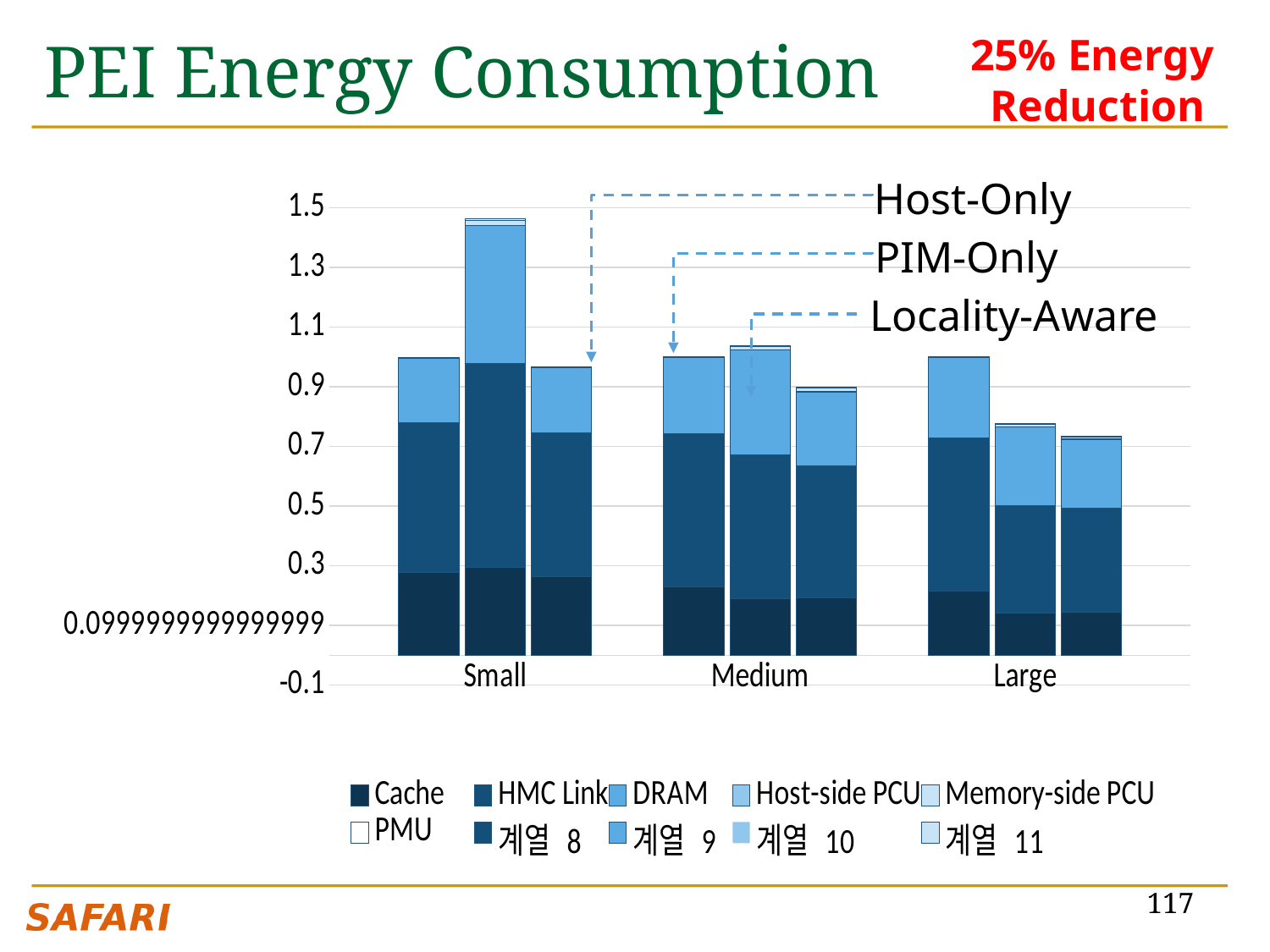
What kind of chart is shown on the slide? stacked bar chart Is the total of the PIM-Only bar for Large greater or less than 0.9? less What energy reduction is highlighted in red at the top right of the slide? 25% Energy Reduction Is the total of the Locality-Aware bar for Large greater or less than 0.9? less How many series does the chart's legend list? 10 For Small, which is larger: the PIM-Only bar or the Host-Only bar? PIM-Only Which bar in the chart is the tallest overall? PIM-Only for Small What is the title of the chart on the slide? PEI Energy Consumption Do the PIM-Only bars rise or fall going from Small to Medium to Large? fall How many categories are shown on the x axis of the chart? 3 For Large, which is larger: the Host-Only bar or the Locality-Aware bar? Host-Only Is the total of the PIM-Only bar for Small greater or less than 1.3? greater